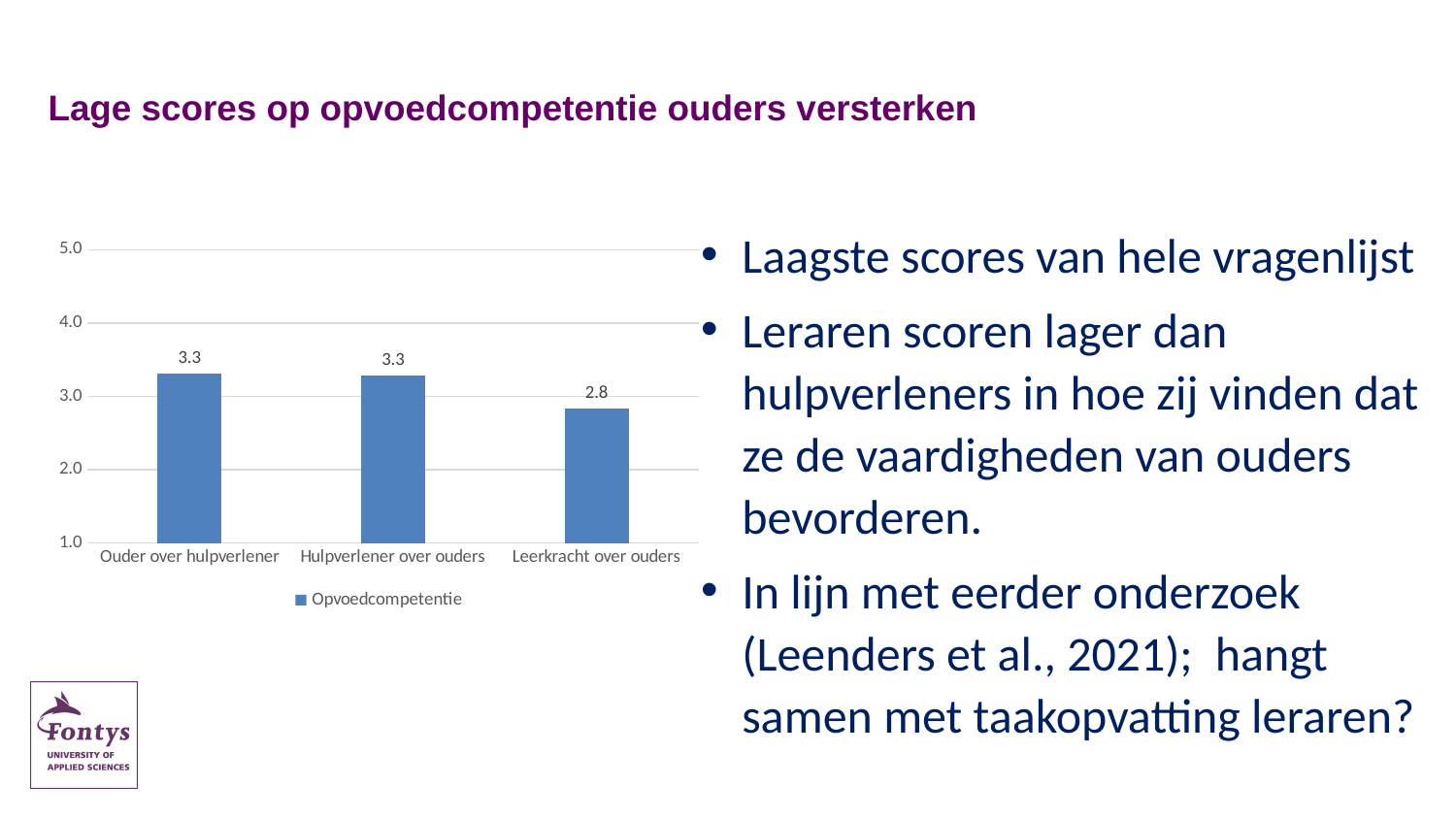
Is the value for Leerkracht over ouders greater or less than 3.0? less What is the name of the series shown in the legend? Opvoedcompetentie Which is larger: the value for Ouder over hulpverlener or the value for Leerkracht over ouders? Ouder over hulpverlener What is the difference between the values for Hulpverlener over ouders and Leerkracht over ouders? 0.5 Is the value for Ouder over hulpverlener greater or less than 3.0? greater What is the value for Leerkracht over ouders? 2.8 What is the value for Ouder over hulpverlener? 3.3 What kind of chart is shown on the slide? bar chart How many categories are shown on the x axis? 3 How many series does the legend list? 1 Which category has the lowest value? Leerkracht over ouders What is the value for Hulpverlener over ouders? 3.3